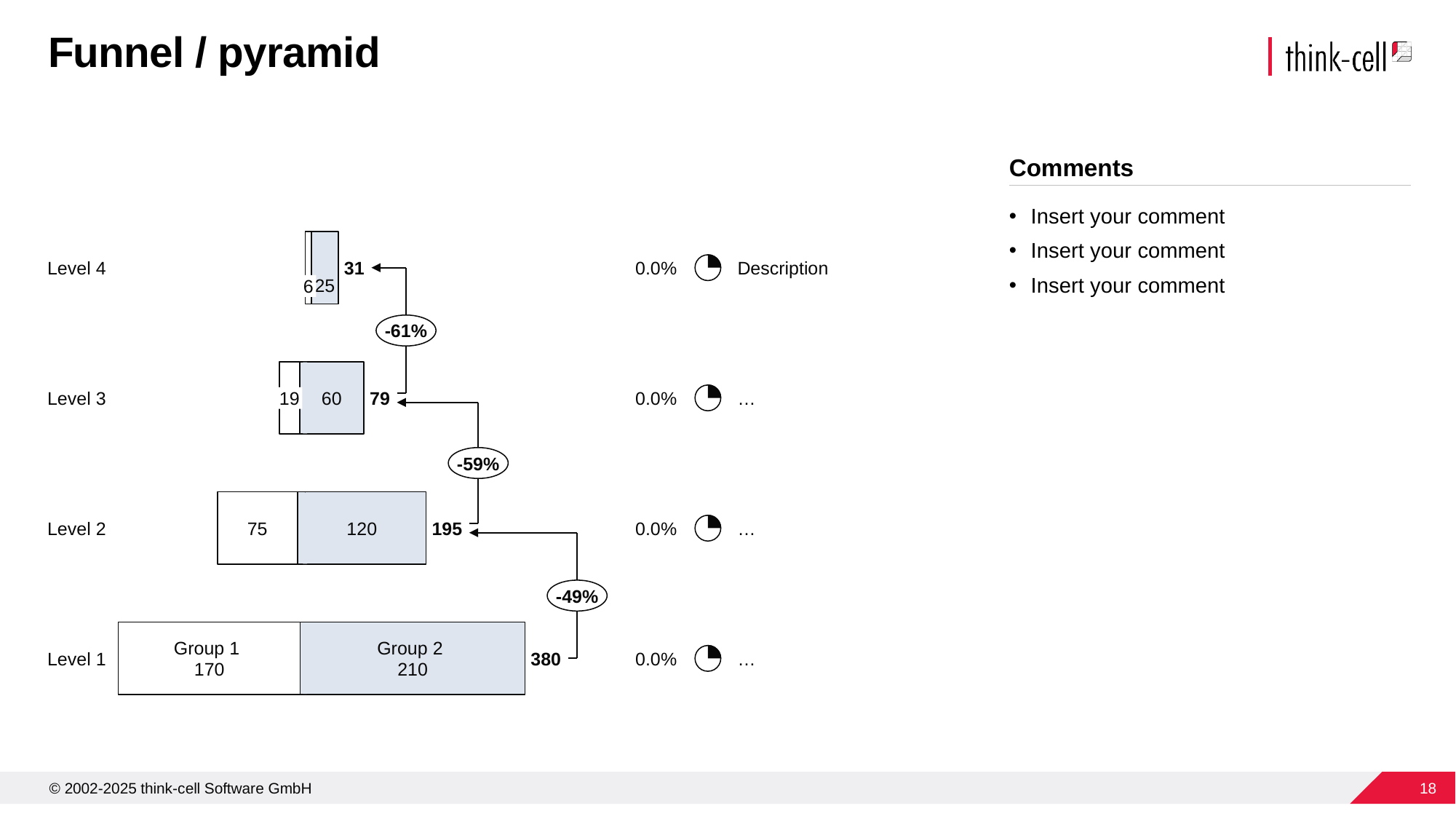
What is the difference between the total for Level 1 and the total for Level 2? 185 Which level has the highest total value? Level 1 What is the total value for Level 3? 79 What kind of chart is shown on the slide? Funnel / pyramid (stacked bar chart) What is the Group 2 value for Level 1? 210 Which is larger for Level 3, the Group 1 value or the Group 2 value? Group 2 What percentage change is shown between Level 2 and Level 3? -59% What is the total value for Level 1? 380 Which level has the lowest total value? Level 4 How many levels are shown in the chart? 4 What is the Group 2 value for Level 4? 25 What is the Group 1 value for Level 2? 75